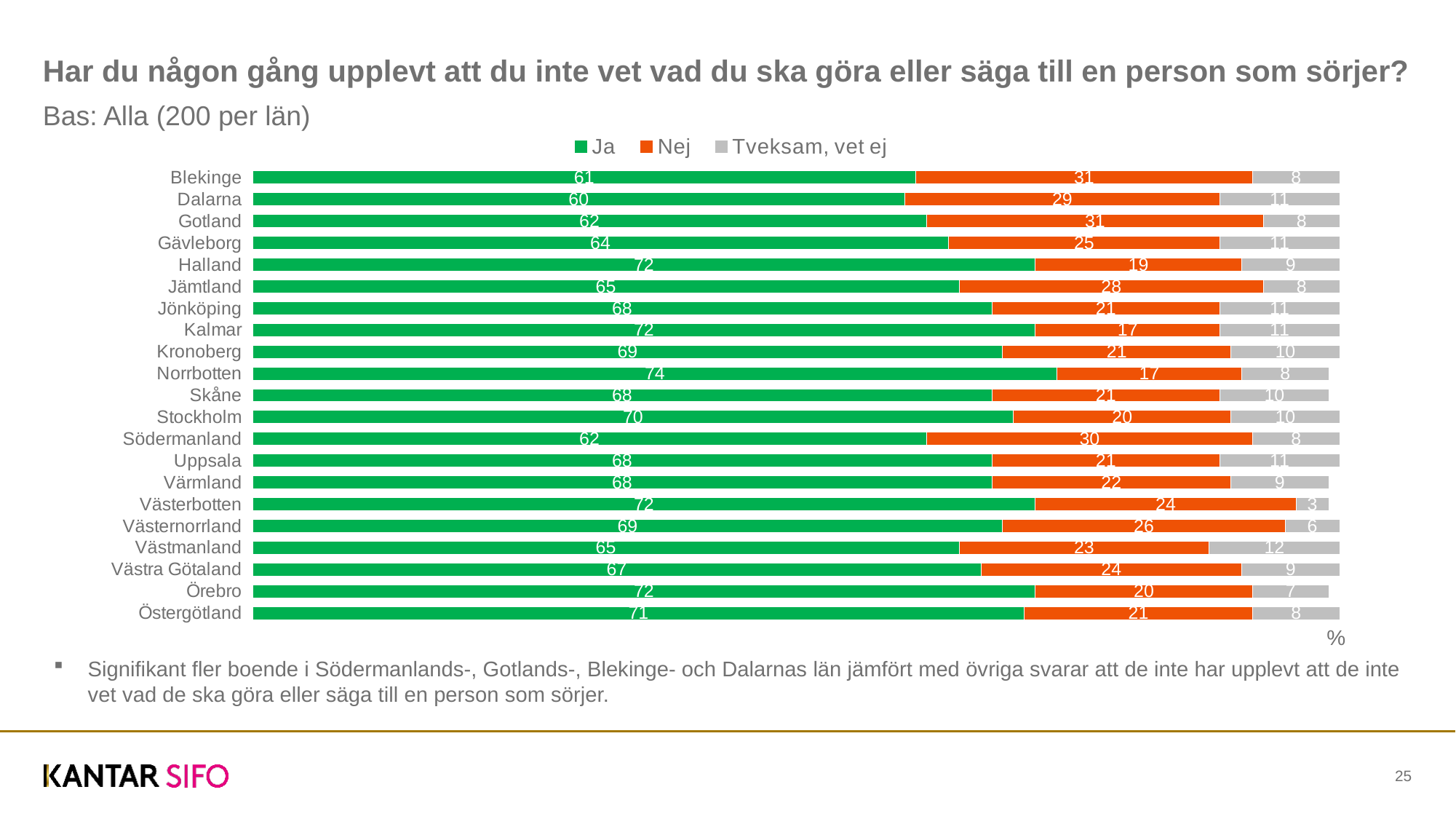
What is the difference between the "Ja" values for Norrbotten and Dalarna? 14 What kind of chart is shown on the slide? Stacked bar chart What is the "Nej" value for Blekinge? 31 Which has a larger "Nej" value, Halland or Jämtland? Jämtland Which county has the lowest "Tveksam, vet ej" value? Västerbotten Which county has the lowest "Ja" value? Dalarna Which county has the highest "Ja" value? Norrbotten How many series does the legend list? 3 How many counties are shown in the chart? 21 What is the total of the stacked bar for Västerbotten? 99 What is the "Tveksam, vet ej" value for Västmanland? 12 What percentage of respondents in Norrbotten answered "Ja"? 74